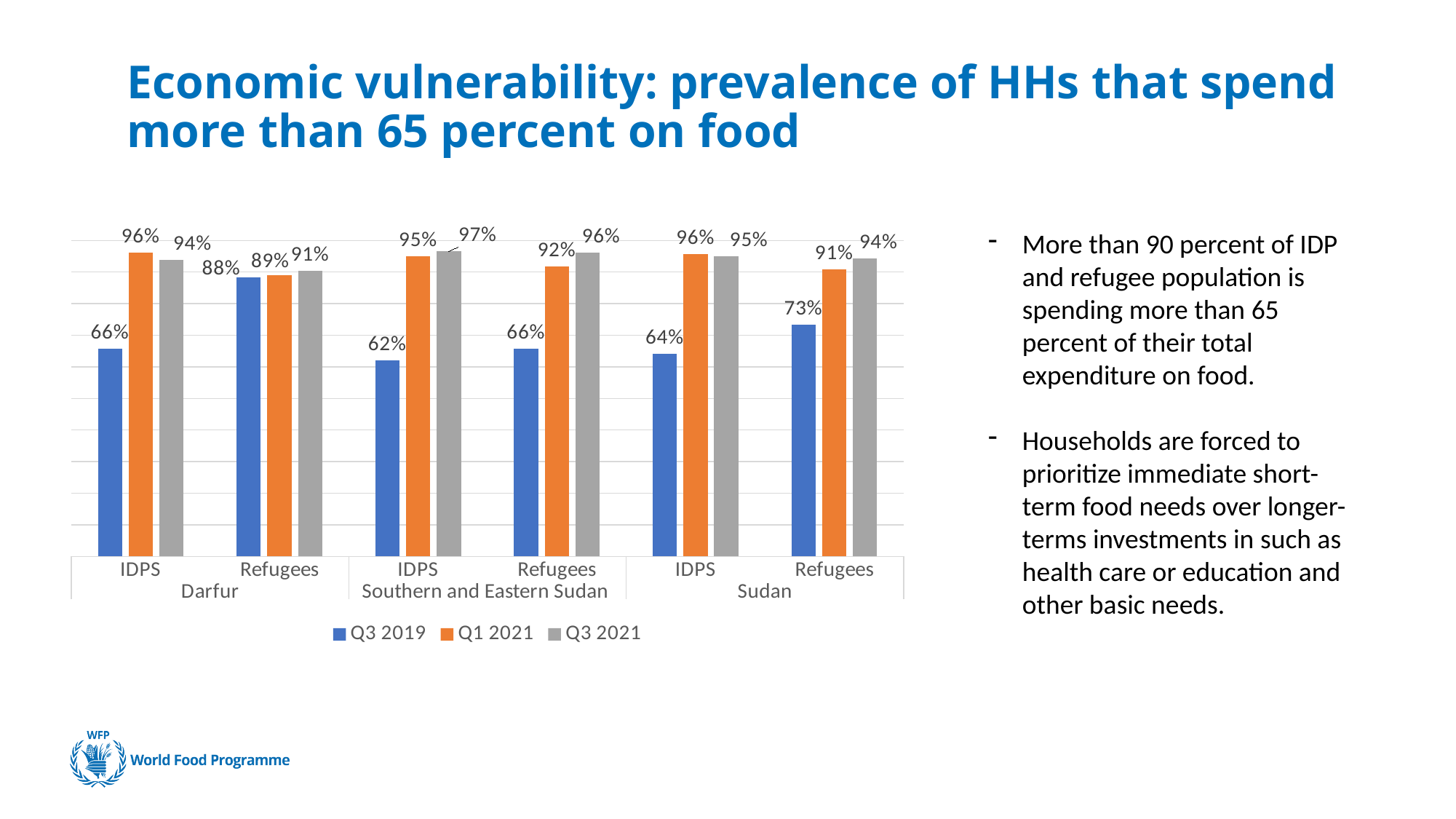
How many series does the legend list? 3 What is the difference between the Q1 2021 and Q3 2019 values for IDPS in Darfur? 30% What is the Q3 2019 value for IDPS in Darfur? 66% Which category group has the lowest Q3 2019 value? IDPS in Southern and Eastern Sudan What is the Q1 2021 value for Refugees in Sudan? 91% Which is larger for Refugees in Darfur: the Q3 2019 value or the Q3 2021 value? Q3 2021 How many category groups (bar clusters) are shown on the x axis? 6 Which category group has the highest Q3 2021 value? IDPS in Southern and Eastern Sudan What is the Q3 2021 value for IDPS in Southern and Eastern Sudan? 97% What kind of chart is shown on the slide? Bar chart Which colour represents the Q1 2021 series in the legend? Orange What is the difference between the Q3 2021 and Q3 2019 values for Refugees in Sudan? 21%